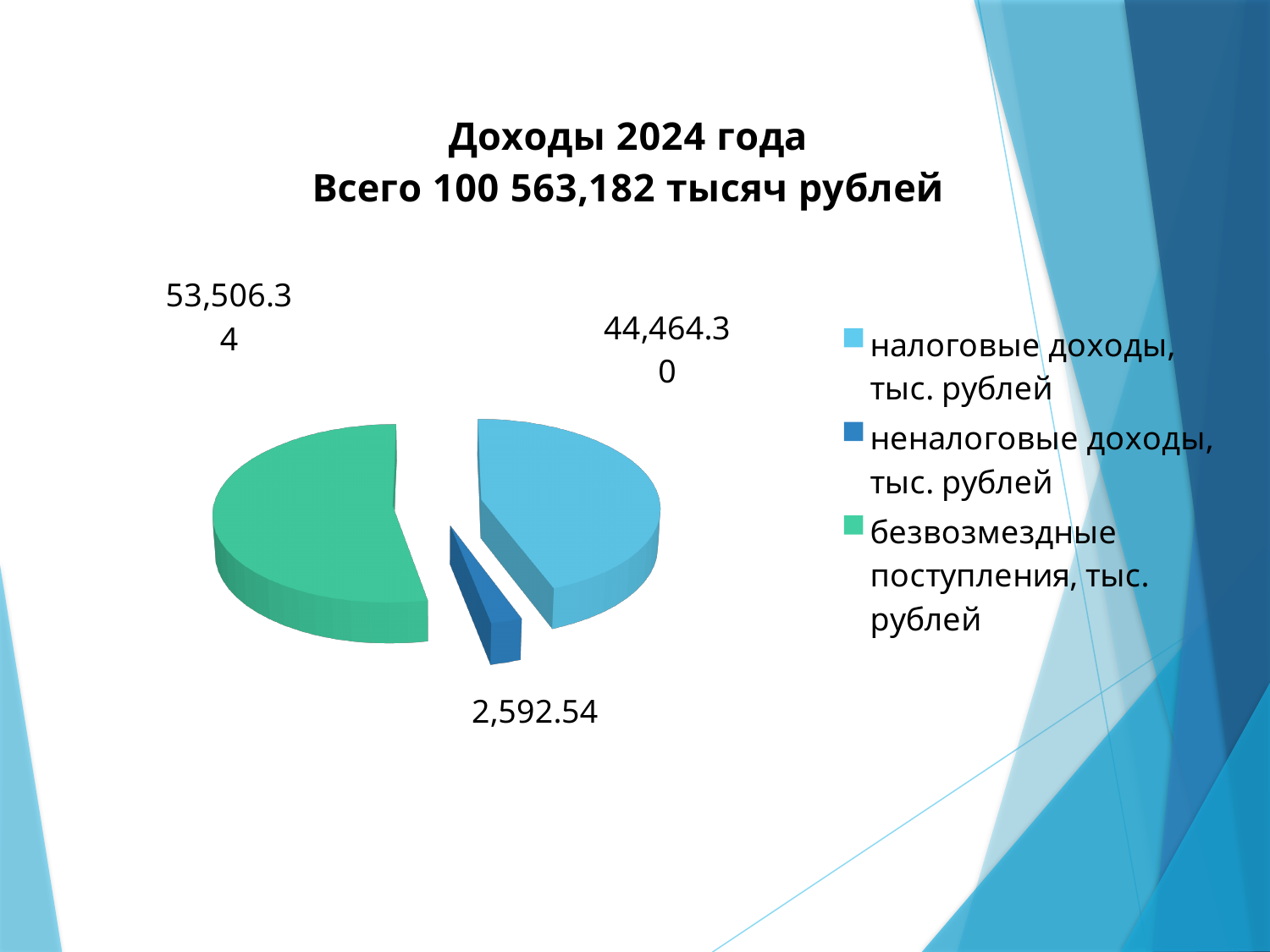
What is the value of the неналоговые доходы slice? 2,592.54 What kind of chart is shown on the slide? pie chart What colour is the безвозмездные поступления slice? green How many slices does the pie chart have? 3 What is the value of the безвозмездные поступления slice? 53,506.34 How many entries does the legend list? 3 What is the value of the налоговые доходы slice? 44,464.30 Which category has the smallest slice of the pie? неналоговые доходы, тыс. рублей Which is larger: налоговые доходы or неналоговые доходы? налоговые доходы What is the difference between the безвозмездные поступления value and the налоговые доходы value? 9,042.04 Which category has the largest slice of the pie? безвозмездные поступления, тыс. рублей What is the title of the chart? Доходы 2024 года Всего 100 563,182 тысяч рублей